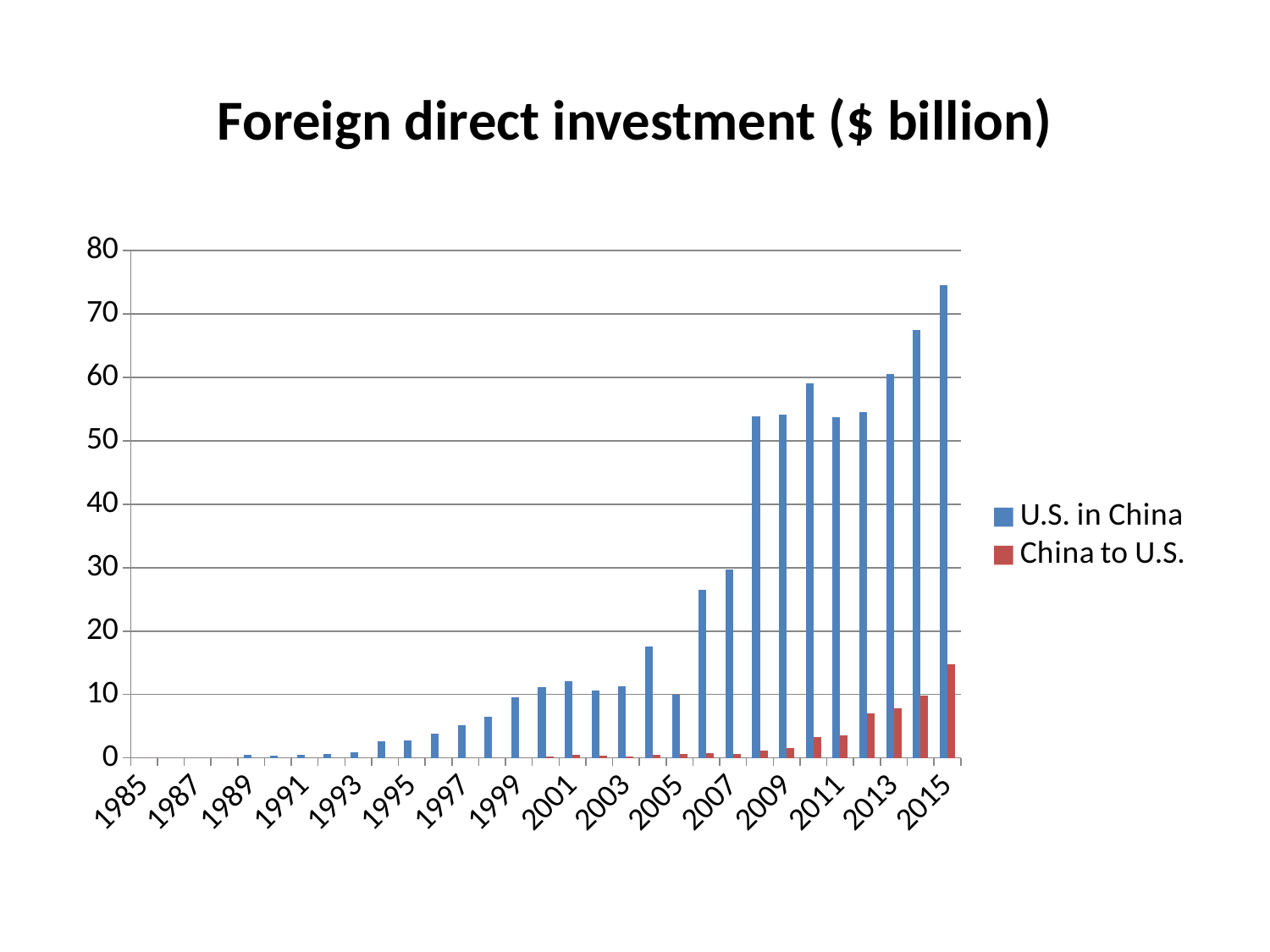
In which year is the U.S. in China value highest? 2015 Is the China to U.S. value for 2013 greater or less than 10? less In 2015, which is larger: U.S. in China or China to U.S.? U.S. in China What is the title of the chart? Foreign direct investment ($ billion) What kind of chart is shown on the slide? bar chart In which year is the China to U.S. value highest? 2015 Is the U.S. in China value for 2015 greater or less than 70? greater Is the China to U.S. value for 2015 greater or less than 10? greater Which series is shown in red? China to U.S. Does the China to U.S. series generally rise or fall from 2001 to 2015? rise How many series does the legend list? 2